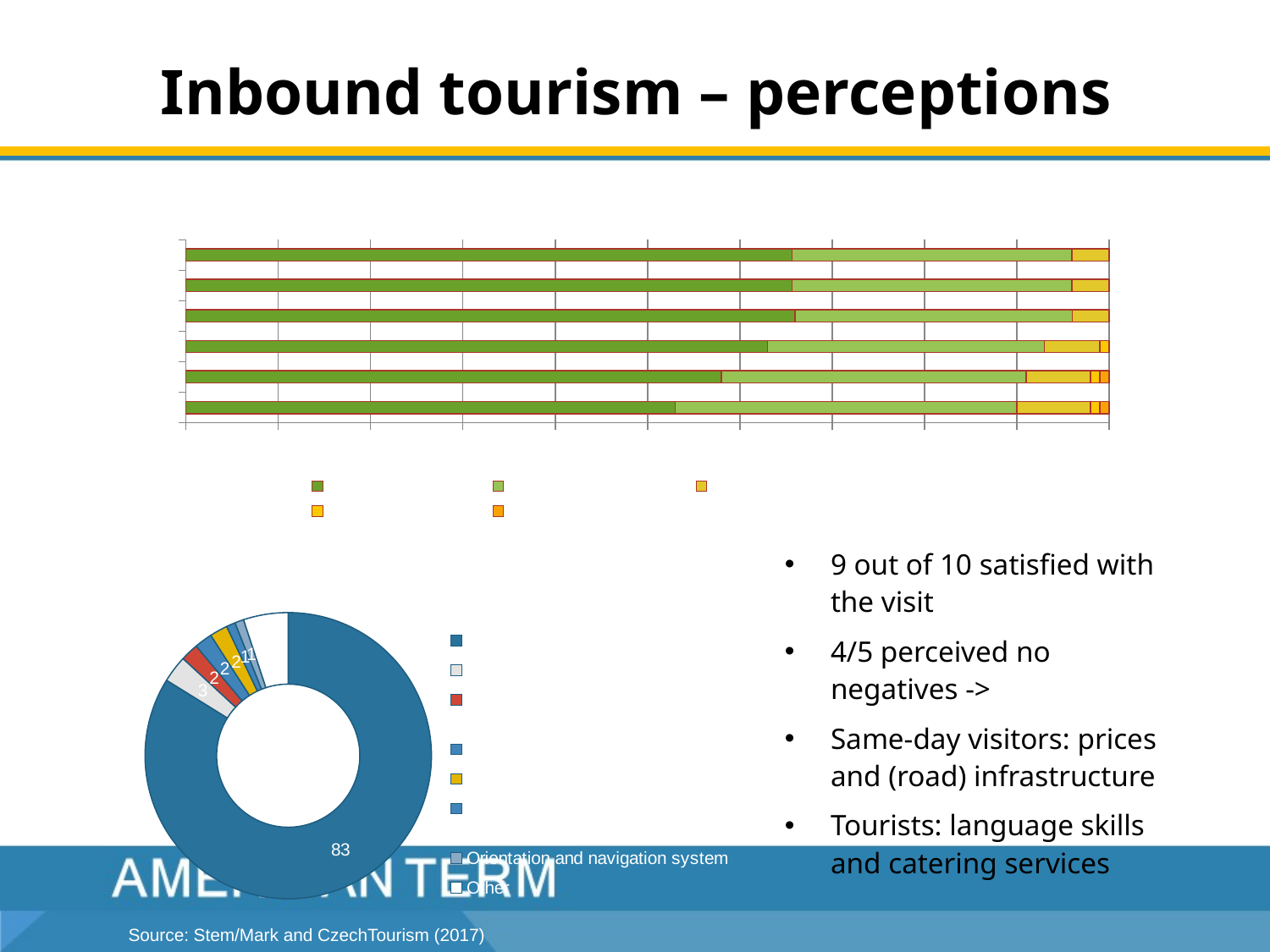
In the doughnut chart at the bottom left, is the largest slice greater or less than 50? greater What is the title of the slide? Inbound tourism – perceptions In the doughnut chart at the bottom left, what is the value of the largest slice? 83 How many bars does the chart at the top of the slide show? 6 In the chart at the top of the slide, is the dark green segment longer in the top bar or in the bottom bar? top bar What kind of chart is the chart at the bottom left of the slide? doughnut chart In the chart at the top of the slide, does the dark green segment get longer or shorter going from the top bar to the bottom bar? shorter What is the last legend entry of the doughnut chart at the bottom left? Other What kind of chart is the chart at the top of the slide? bar chart